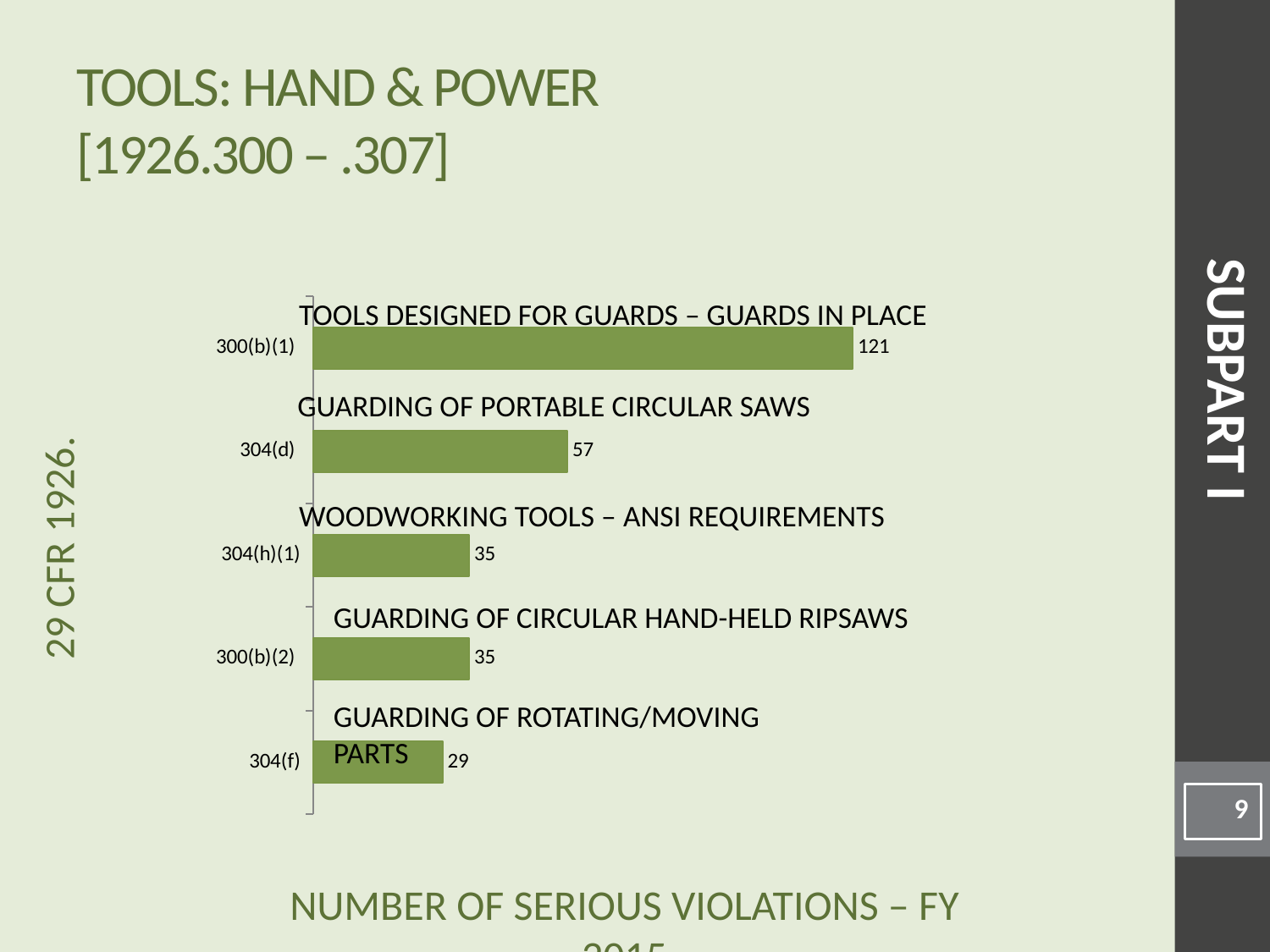
How many categories are shown in the chart? 5 Which is larger, the value for 304(d) or the value for 304(h)(1)? 304(d) What is the value for 300(b)(2)? 35 What is the number of serious violations for 300(b)(1)? 121 What kind of chart is shown on the slide? bar chart What is the number of serious violations for 304(f)? 29 Which category has the highest number of serious violations? 300(b)(1) What is the difference between the values for 304(d) and 304(f)? 28 What is the difference between the values for 300(b)(1) and 304(d)? 64 What is the number of serious violations for 304(d)? 57 What is the label of the bar for 304(d)? GUARDING OF PORTABLE CIRCULAR SAWS Which category has the lowest number of serious violations? 304(f)